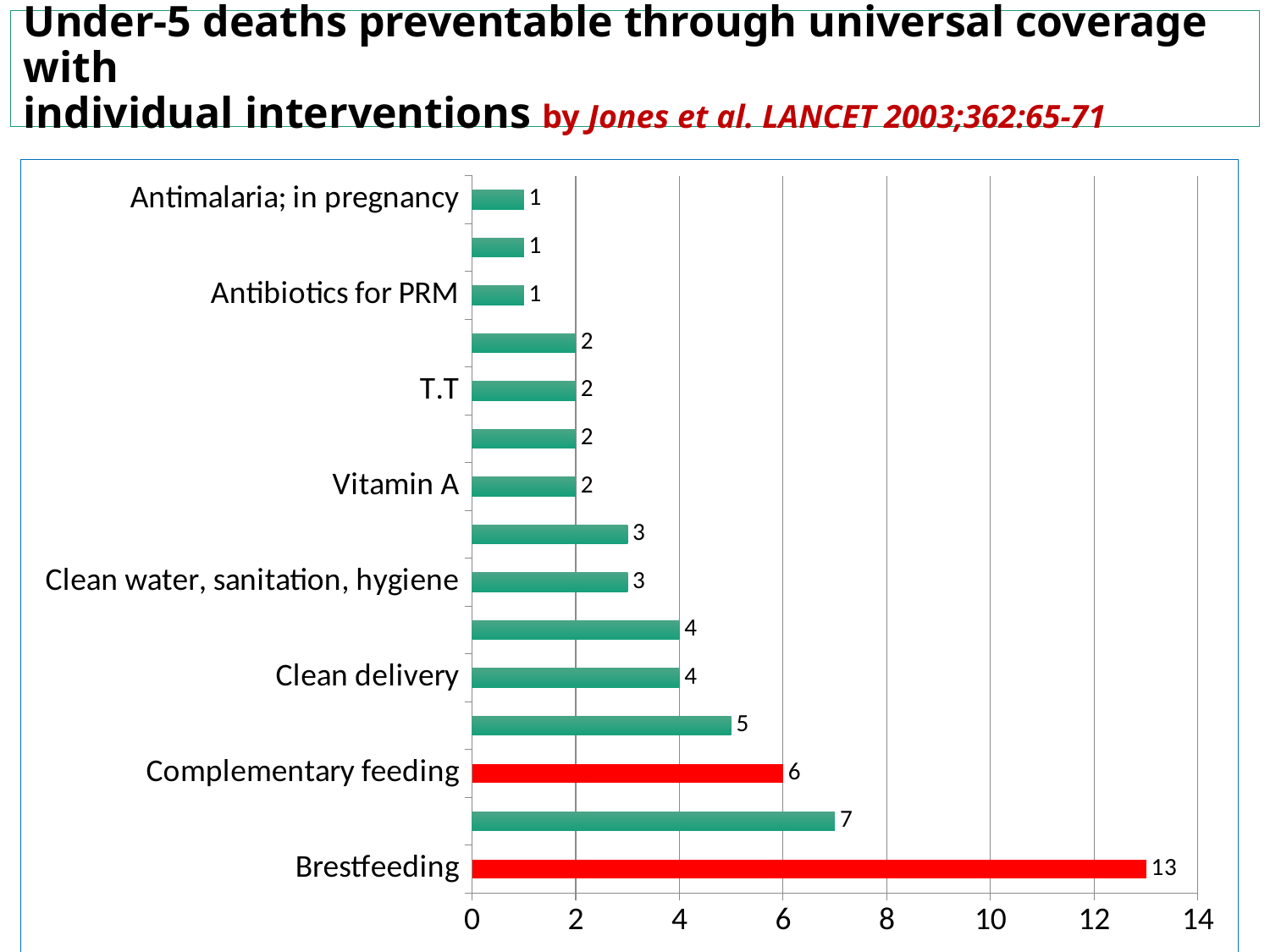
What value is shown for Clean water, sanitation, hygiene? 3 What value is shown for Clean delivery? 4 How many bars are plotted in the chart? 15 What value is shown for Complementary feeding? 6 What colour is the bar for Brestfeeding? Red What value is shown for Vitamin A? 2 What kind of chart is shown on the slide? Bar chart What value is shown for Antibiotics for PRM? 1 Which intervention has the highest value? Brestfeeding Which has a larger value, Clean delivery or T.T? Clean delivery What value is shown for Brestfeeding? 13 What is the difference between the values for Brestfeeding and Complementary feeding? 7